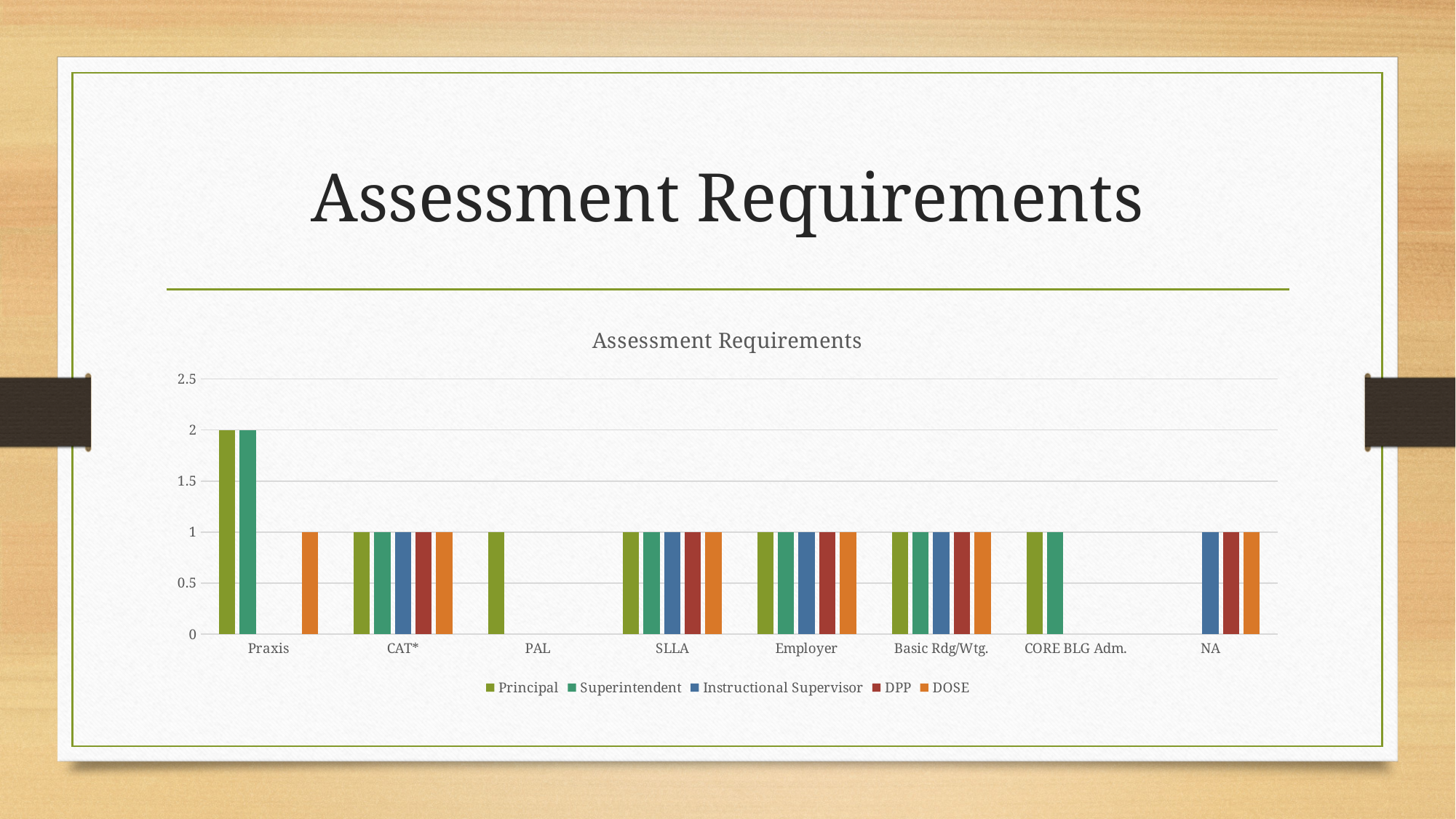
In which category does the Principal series reach its highest value? Praxis What is the value for Superintendent in the SLLA category? 1 What kind of chart is shown on the slide? Bar chart How many series does the chart's legend list? 5 Which is larger in the Praxis category: the Superintendent value or the DOSE value? Superintendent What is the title of the chart? Assessment Requirements What is the value for Principal in the Praxis category? 2 What is the difference between the Principal value and the DOSE value in the Praxis category? 1 How many categories are shown along the x axis of the chart? 8 Which series is the only one with a bar in the PAL category? Principal Is the value for Superintendent in the Praxis category greater or less than 1.5? greater What is the value for DOSE in the Praxis category? 1